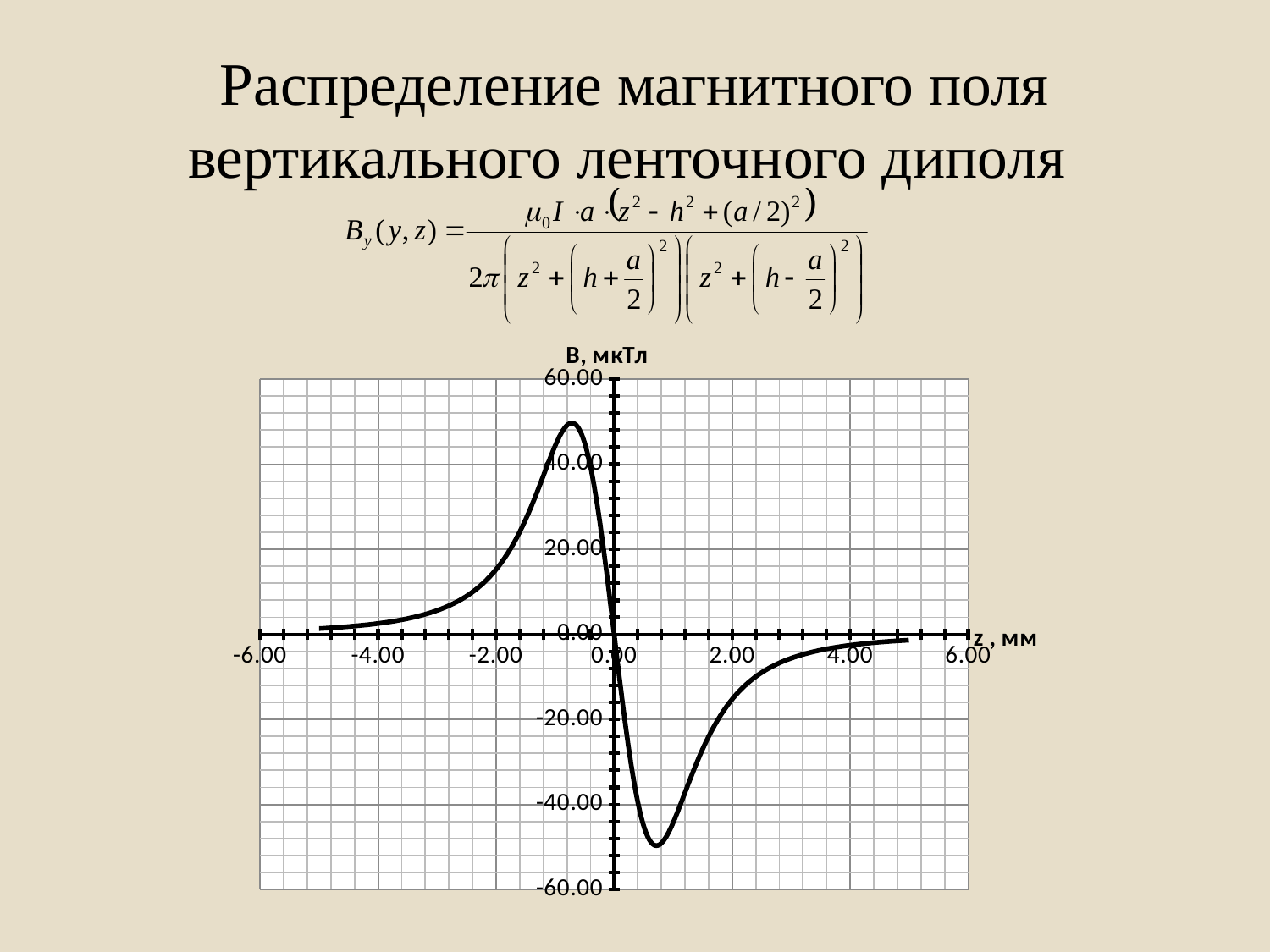
Is the value of B at z = -2.00 greater or less than 20.00? less Which is larger, the value of B at z = -2.00 or at z = 2.00? z = -2.00 Is the value of B at z = -4.00 greater or less than 0.00? greater Is the lowest value of the curve greater or less than -40.00? less What is the label of the vertical axis of the chart? B, мкТл How many lines (series) are plotted on the chart? 1 What is the label of the horizontal axis of the chart? z, мм Does the curve rise or fall as z goes from -4.00 to -1.00? rise Does the curve rise or fall as z goes from 1.00 to 4.00? rise What kind of chart is shown on the slide? line chart